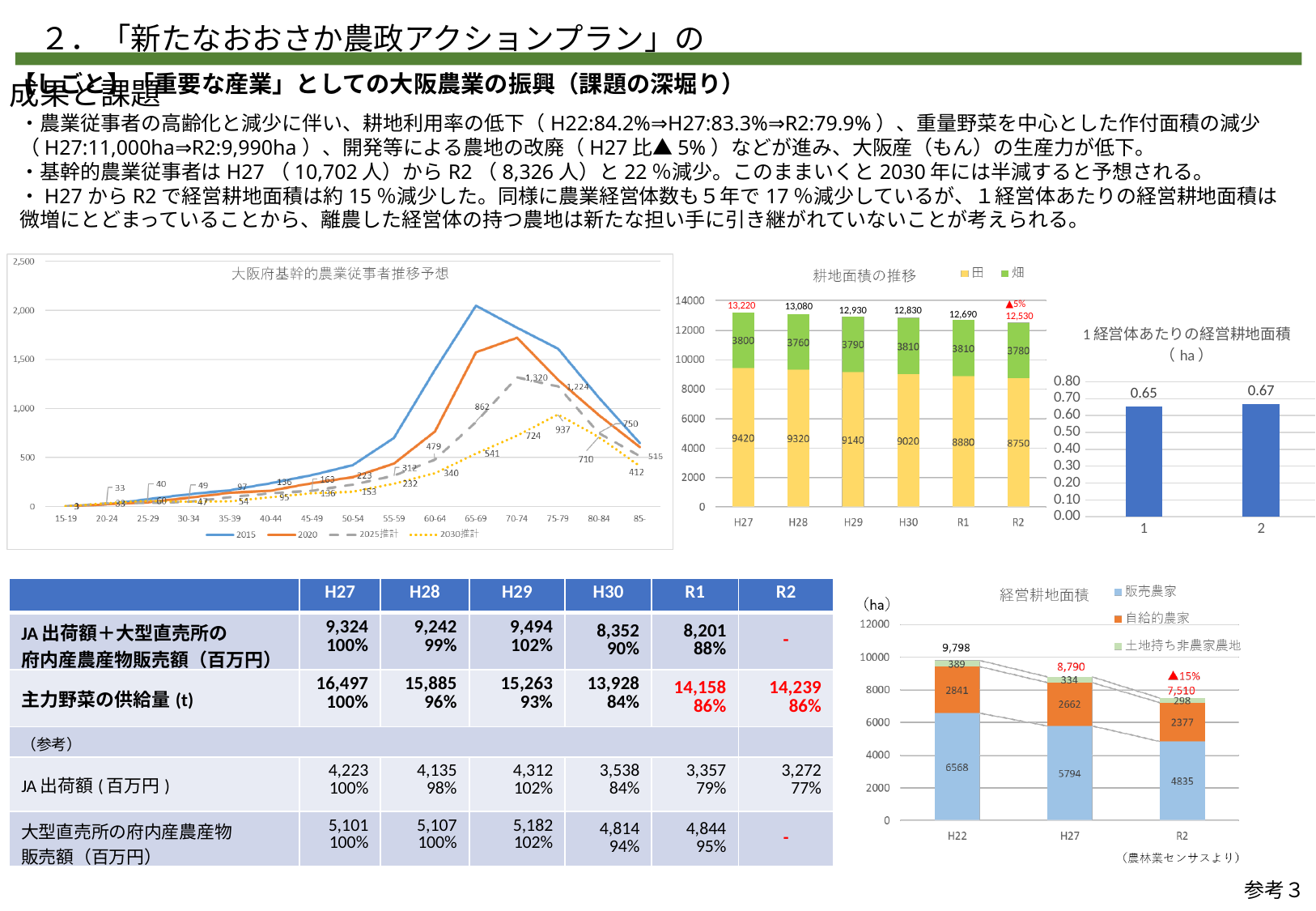
In the 耕地面積の推移 chart, what is the 田 value for R2? 8750 What kind of chart is the 大阪府基幹的農業従事者推移予想 chart? line chart In the 1経営体あたりの経営耕地面積 chart, which category has the higher value, 1 or 2? 2 In the 経営耕地面積 chart, do the totals rise or fall from H22 to R2? fall In the 大阪府基幹的農業従事者推移予想 chart, how many series does the legend list? 4 In the 耕地面積の推移 chart, how many series does the legend list? 2 In the 耕地面積の推移 chart, what is the difference between the 田 values for H27 and R2? 670 In the 経営耕地面積 chart, what is the total for R2? 7,510 In the 1経営体あたりの経営耕地面積 chart, what is the value for category 2? 0.67 In the 耕地面積の推移 chart, what is the total cultivated area for H27? 13,220 In the 経営耕地面積 chart, what is the 販売農家 value for H22? 6568 In the 耕地面積の推移 chart, which year has the lowest total cultivated area? R2